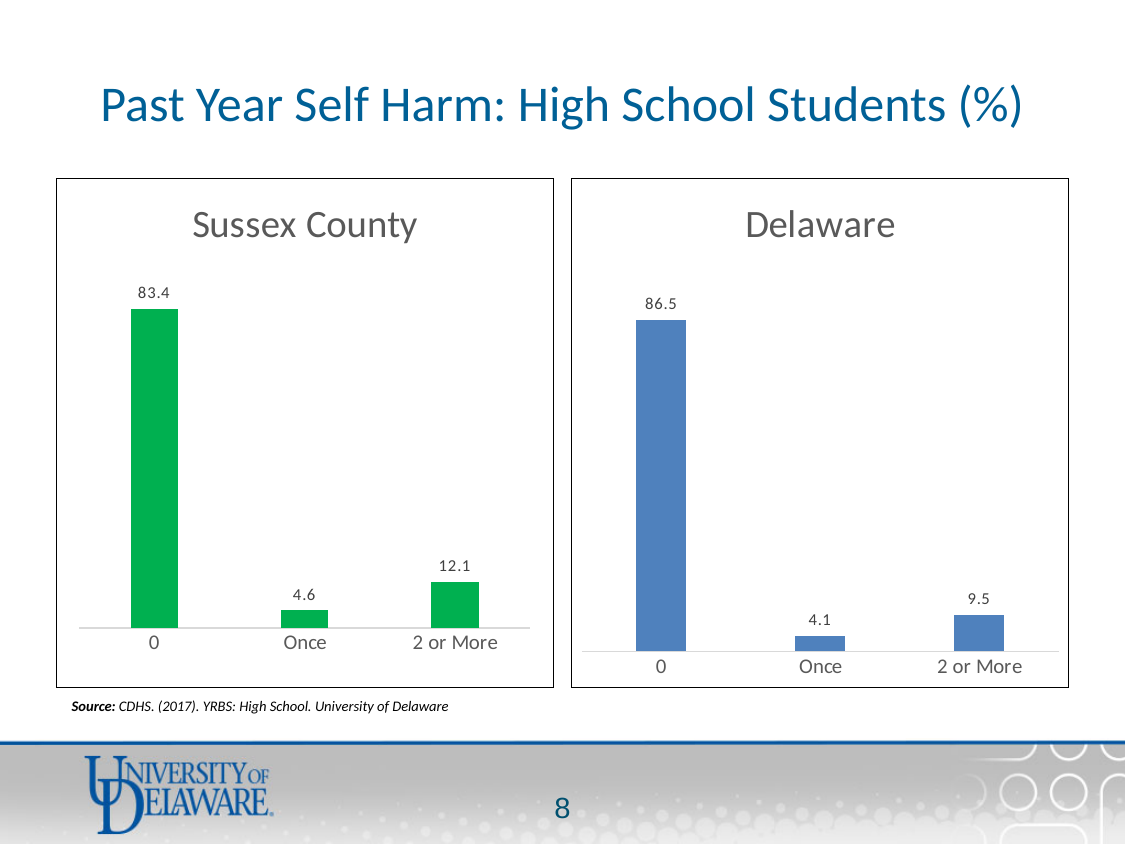
What type of chart is the Sussex County chart? Bar chart What is the difference between the "0" value in the Delaware chart and the "0" value in the Sussex County chart? 3.1 Which chart has the larger value for "2 or More", Sussex County or Delaware? Sussex County In the Sussex County chart, what is the value for the "0" category? 83.4 How many categories are shown in the Delaware chart? 3 In the Delaware chart, which category has the highest value? 0 In the Sussex County chart, what is the difference between the values for "2 or More" and "Once"? 7.5 In the Delaware chart, what is the value for "Once"? 4.1 What colour are the bars in the Delaware chart? Blue In the Sussex County chart, which category has the lowest value? Once In the Sussex County chart, what is the value for "2 or More"? 12.1 In the Delaware chart, what is the value for "2 or More"? 9.5